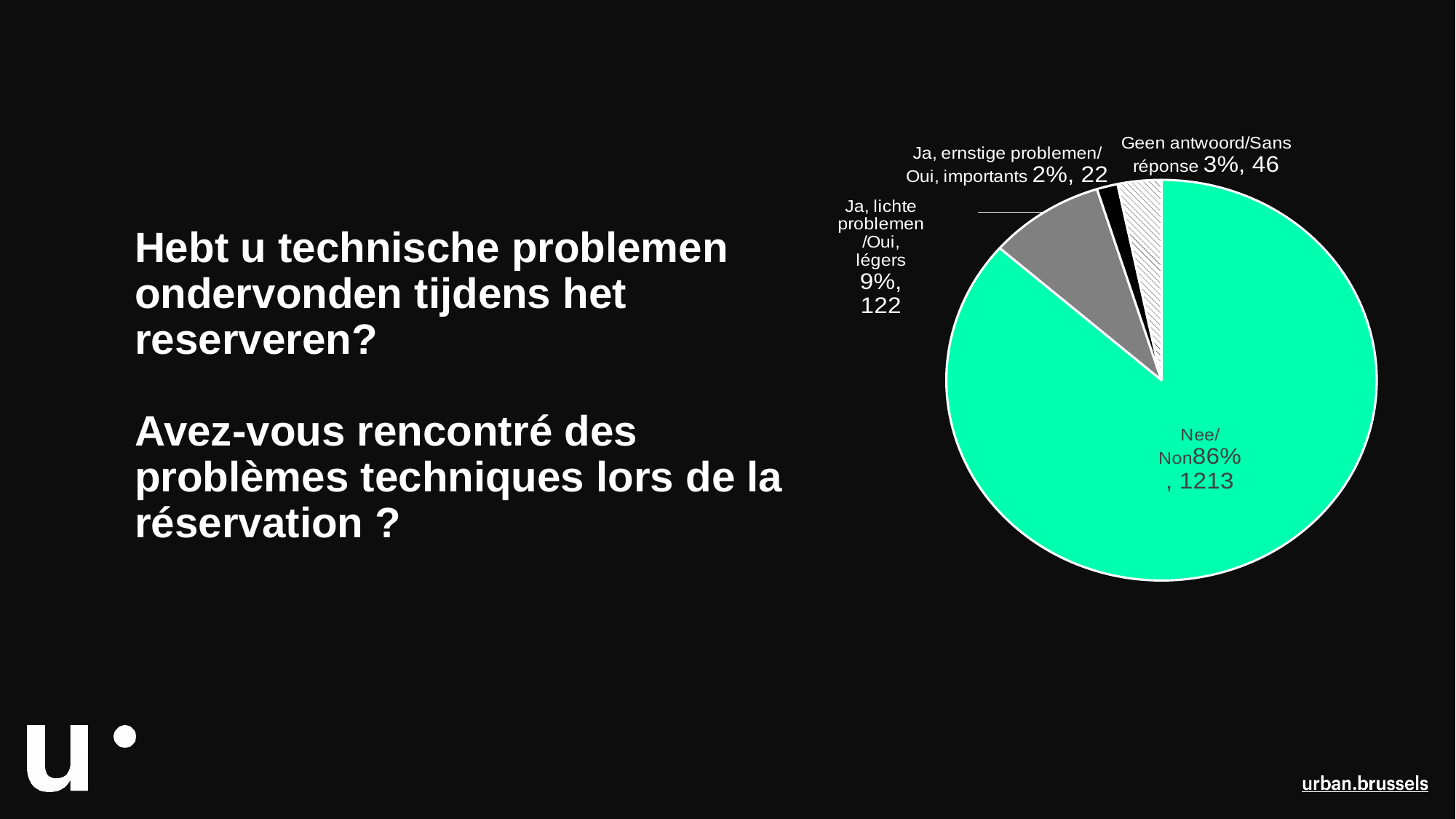
How many slices does the pie chart have? 4 Which category has the smallest slice of the pie? Ja, ernstige problemen/Oui, importants What is the count shown for "Nee/Non"? 1213 What is the count shown for "Ja, lichte problemen/Oui, légers"? 122 Which category has the largest slice of the pie? Nee/Non Which has a larger count: "Geen antwoord/Sans réponse" or "Ja, ernstige problemen/Oui, importants"? Geen antwoord/Sans réponse What is the difference between the counts for "Ja, lichte problemen/Oui, légers" and "Ja, ernstige problemen/Oui, importants"? 100 What colour is the "Nee/Non" slice? green What percentage share does the "Nee/Non" slice have? 86% What percentage share does the "Ja, ernstige problemen/Oui, importants" slice have? 2% What is the count shown for "Geen antwoord/Sans réponse"? 46 What kind of chart is shown on the slide? pie chart